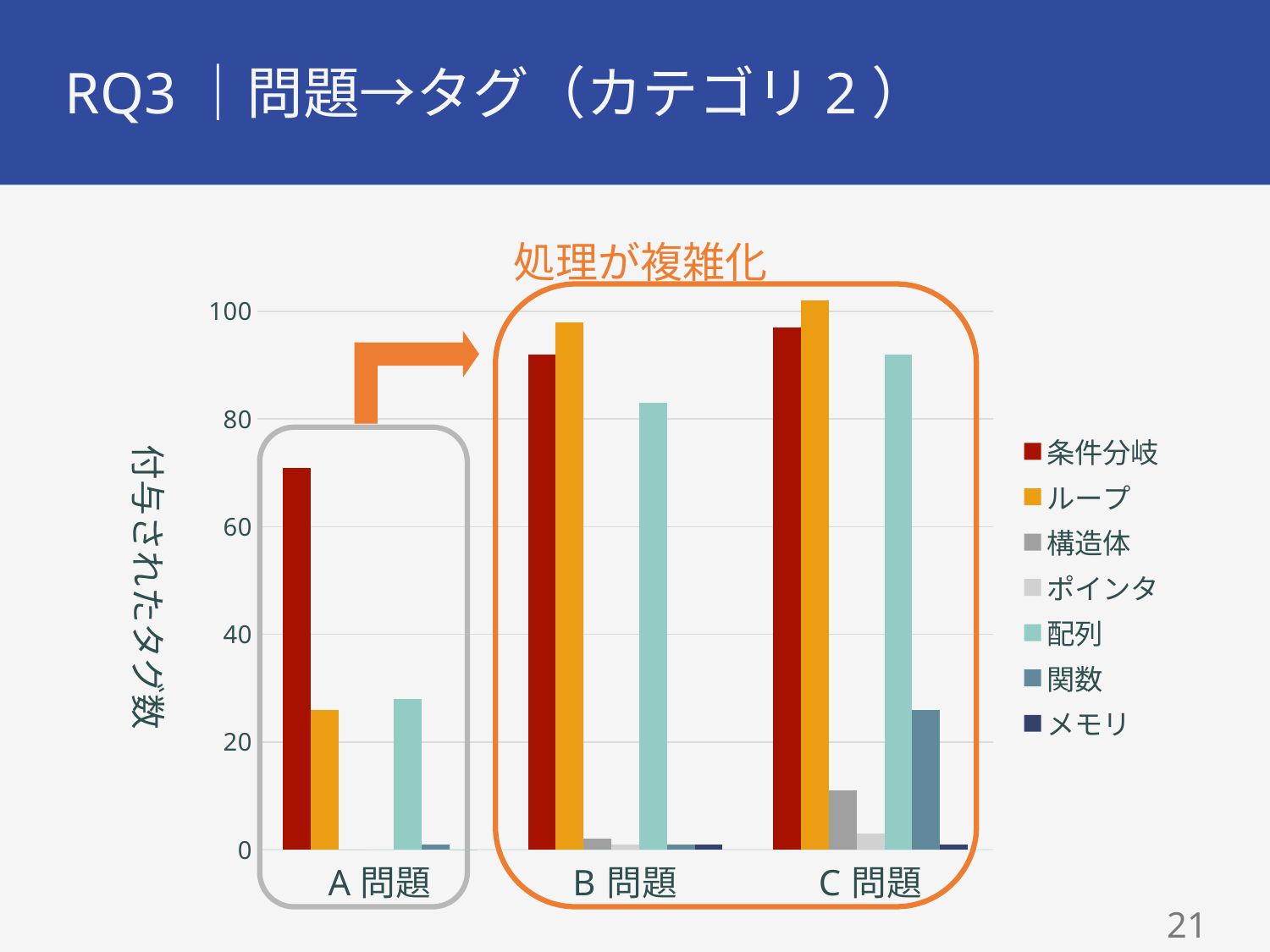
Is the value for 条件分岐 in A 問題 greater or less than 60? greater Do the values for 配列 rise or fall from A 問題 to C 問題? rise Is the value for 関数 in C 問題 greater or less than 20? greater How many series does the legend list? 7 What kind of chart is shown on the slide? bar chart How many categories are shown on the x axis? 3 Is the value for 配列 in B 問題 greater or less than 60? greater Which series has the highest value in A 問題? 条件分岐 Which is larger in A 問題, 条件分岐 or ループ? 条件分岐 What is the label of the y axis? 付与されたタグ数 Which category has the lowest value for 条件分岐? A 問題